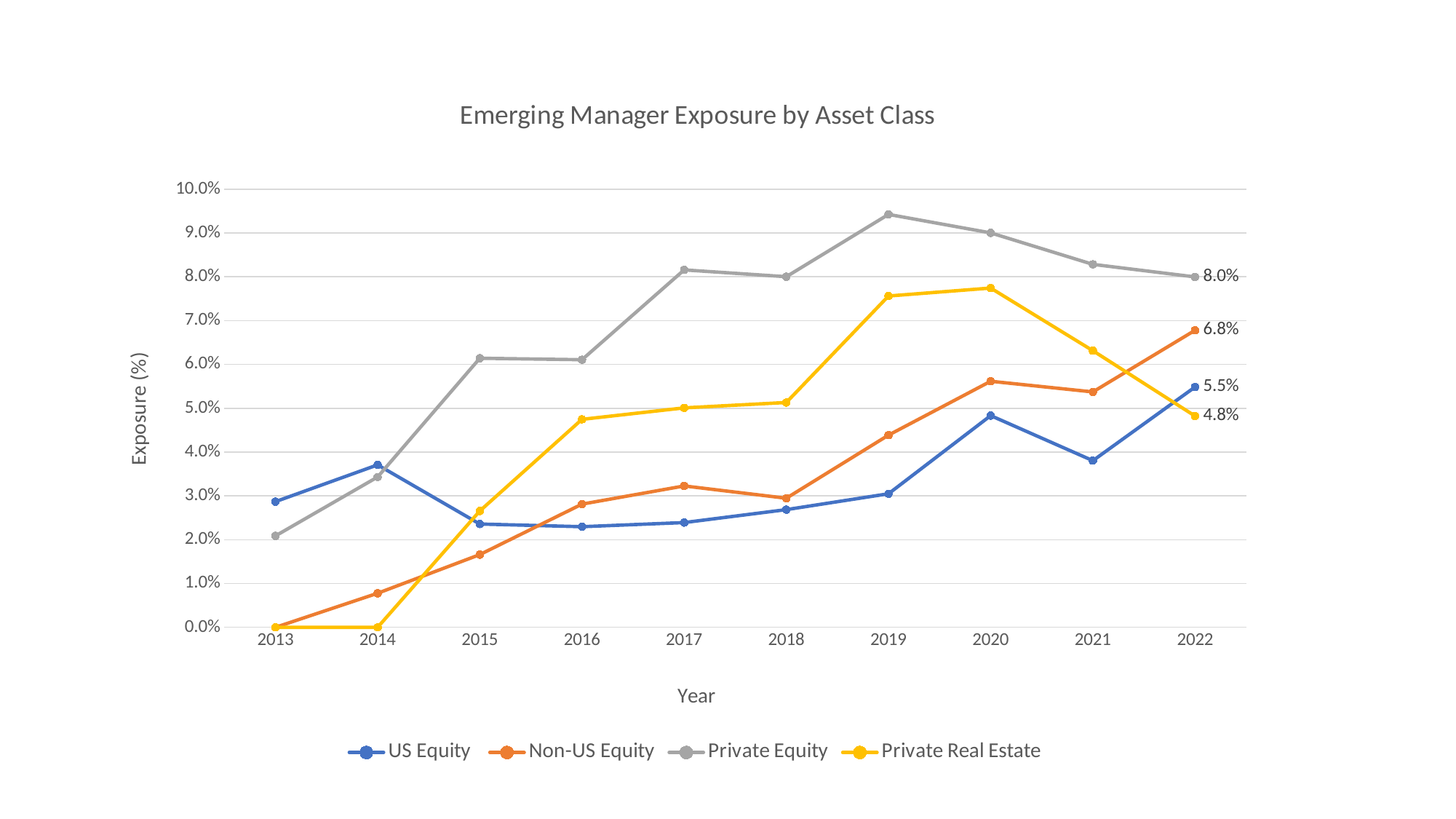
What is the Private Real Estate exposure in 2022? 4.8% What kind of chart is shown on the slide? line chart Which asset class has the highest exposure in 2022? Private Equity Which asset class has the lowest exposure in 2022? Private Real Estate How many years are shown on the x axis? 10 What is the US Equity exposure in 2022? 5.5% What is the difference between the Private Equity and Private Real Estate exposures in 2022? 3.2 percentage points Is the Private Equity exposure in 2019 greater or less than 9.0%? greater What is the Private Real Estate exposure in 2013? 0.0% What is the Private Equity exposure in 2022? 8.0% How many series does the legend list? 4 In 2022, which is larger: Non-US Equity exposure or US Equity exposure? Non-US Equity